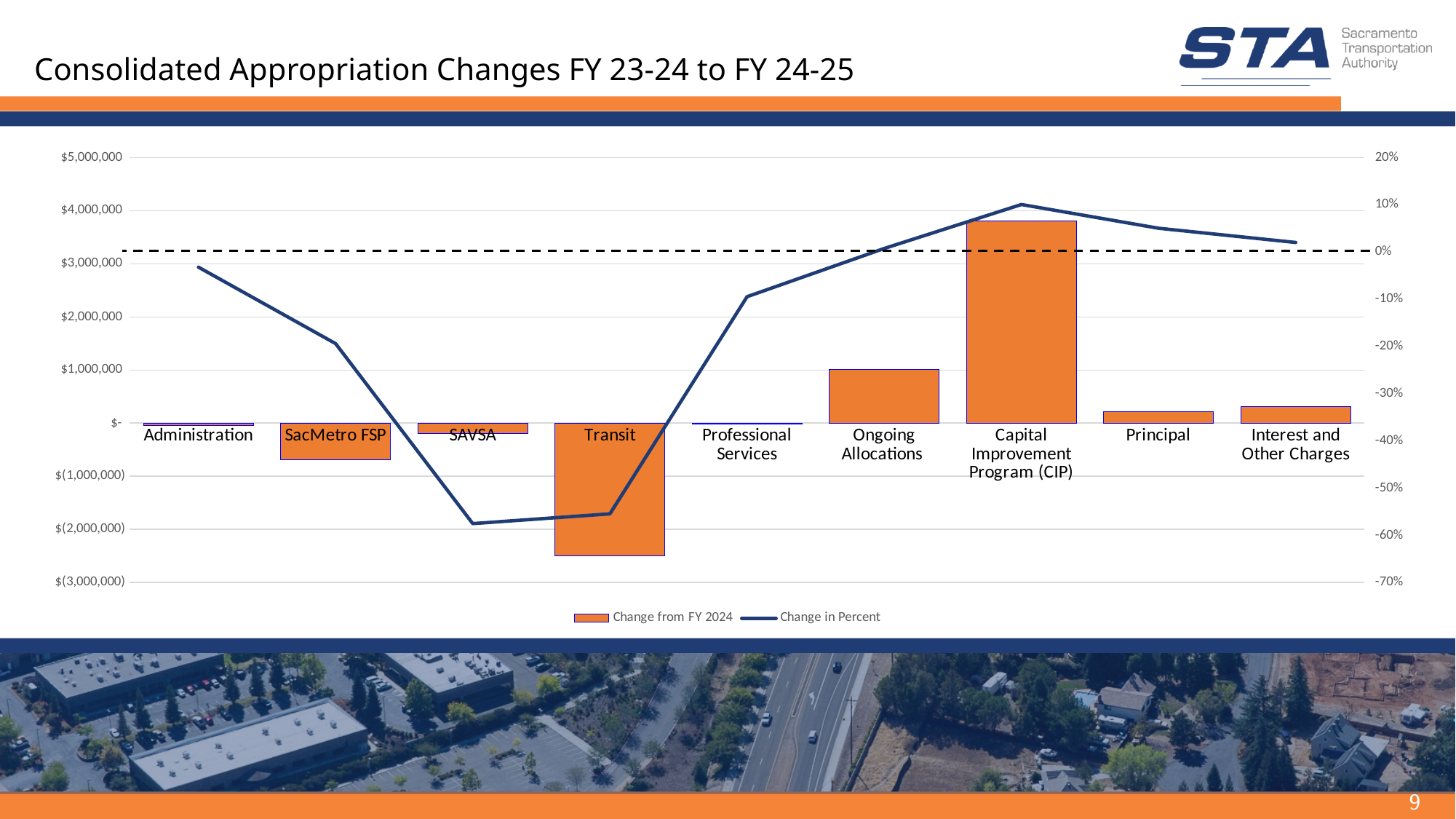
Is the Change in Percent value for SAVSA greater or less than -50%? less What are the two series named in the chart's legend? Change from FY 2024 and Change in Percent Which category has the lowest Change from FY 2024 bar? Transit How many series does the chart's legend list? 2 Which has the larger Change from FY 2024 bar, Capital Improvement Program (CIP) or Ongoing Allocations? Capital Improvement Program (CIP) What kind of chart is shown on the slide? A combined bar and line chart Which category has the highest Change from FY 2024 bar? Capital Improvement Program (CIP) Is the Change from FY 2024 value for Transit greater or less than $(2,000,000)? less Is the Change in Percent value for Administration greater or less than 0%? less Does the Change in Percent line rise or fall from Administration to SAVSA? fall How many categories are shown on the x axis of the chart? 9